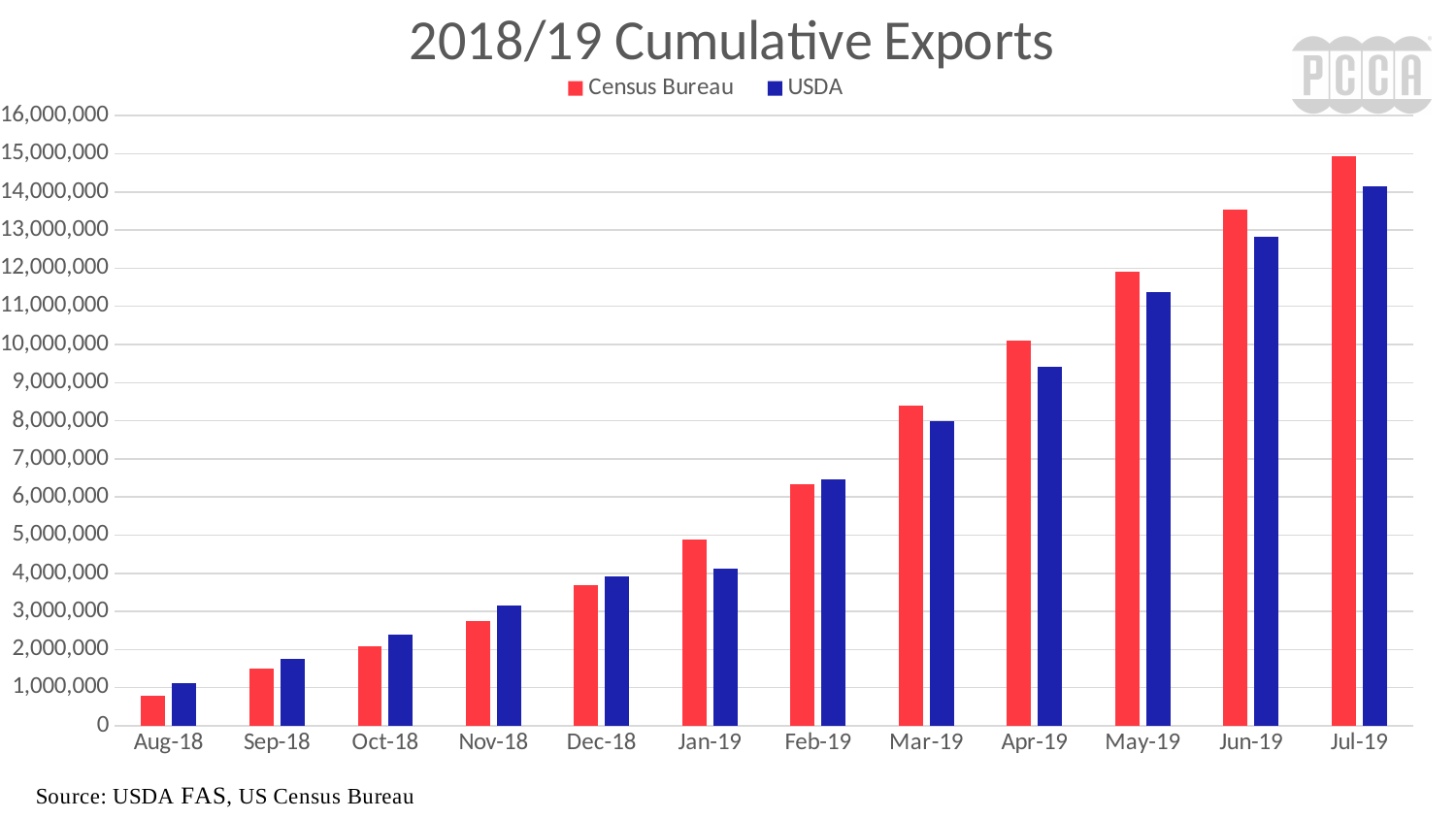
How many months are shown on the x axis? 12 Is the Census Bureau value for Jan-19 greater or less than 4,000,000? greater Is the Census Bureau value for Aug-18 greater or less than 1,000,000? less Is the USDA value for May-19 greater or less than 11,000,000? greater Do the Census Bureau values rise or fall from Aug-18 to Jul-19? Rise In Jul-19, which is larger, the Census Bureau value or the USDA value? Census Bureau In Aug-18, which is larger, the Census Bureau value or the USDA value? USDA Which month has the highest Census Bureau value? Jul-19 Which month has the lowest USDA value? Aug-18 What kind of chart is shown on the slide? Bar chart How many series does the legend list? 2